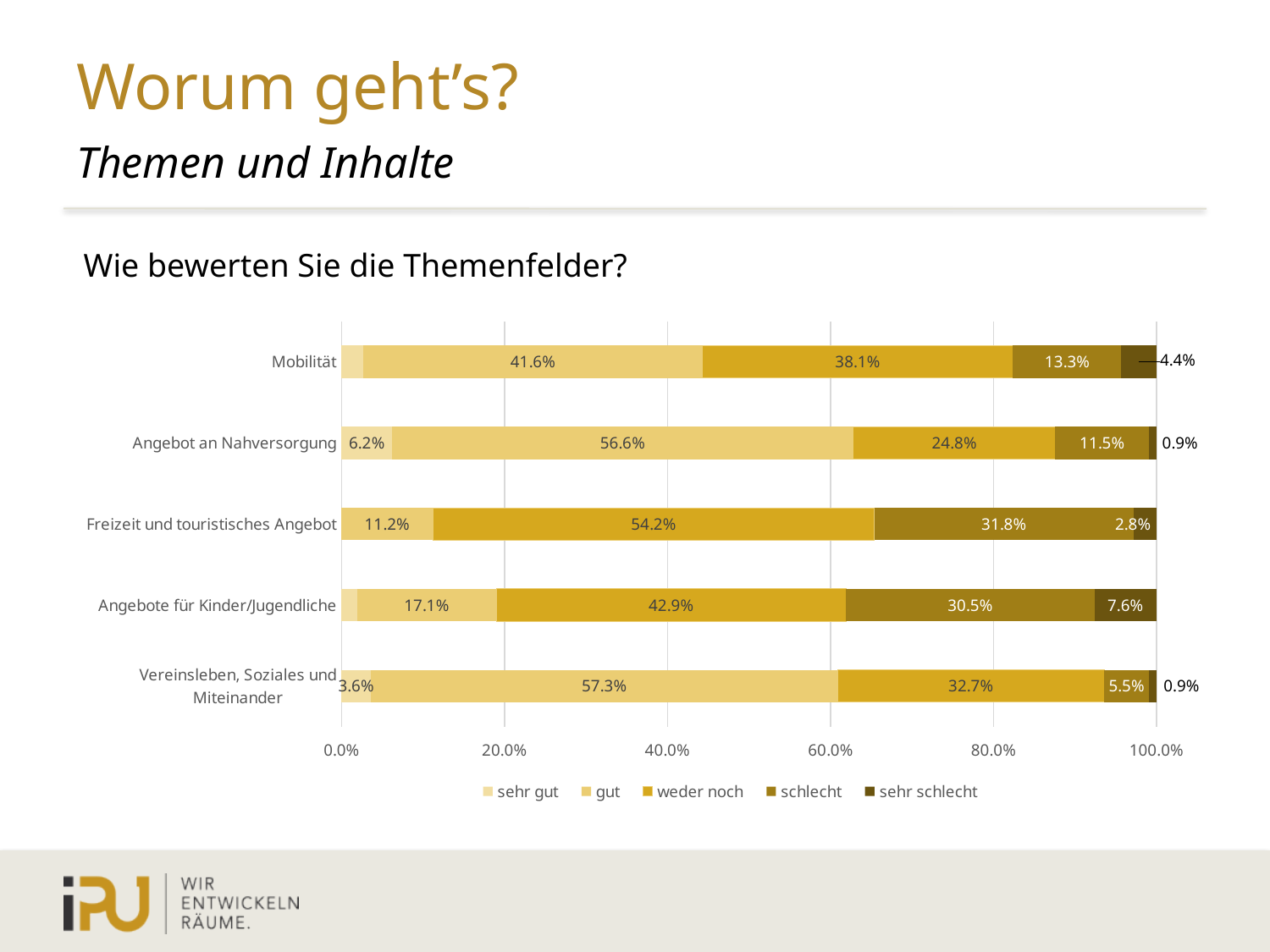
What is the 'schlecht' value for Mobilität? 13.3% What is the first entry in the chart's legend? sehr gut How many series does the legend list? 5 What kind of chart is shown on the slide? bar chart What is the 'weder noch' value for Vereinsleben, Soziales und Miteinander? 32.7% What is the difference between the 'schlecht' values for Mobilität and Angebot an Nahversorgung? 1.8 percentage points How many categories (Themenfelder) are plotted on the chart? 5 What is the 'gut' value for Angebot an Nahversorgung? 56.6% Which has the larger 'gut' value: Angebot an Nahversorgung or Vereinsleben, Soziales und Miteinander? Vereinsleben, Soziales und Miteinander Which category has the highest 'sehr schlecht' value? Angebote für Kinder/Jugendliche What is the 'sehr gut' value for Vereinsleben, Soziales und Miteinander? 3.6% What is the 'sehr schlecht' value for Angebote für Kinder/Jugendliche? 7.6%